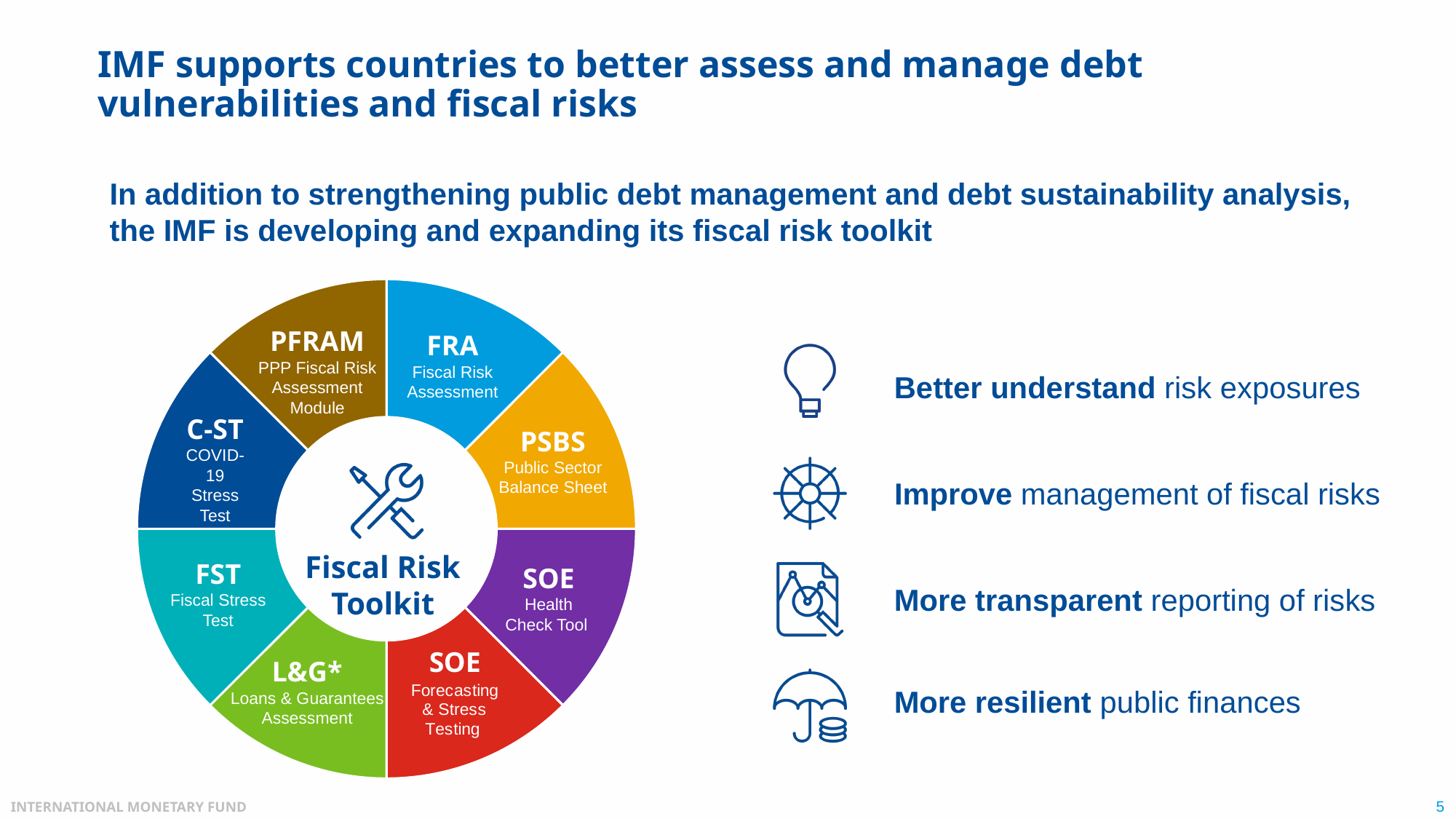
What does the FST segment of the ring diagram stand for? Fiscal Stress Test What does the C-ST segment of the ring diagram stand for? COVID-19 Stress Test How many segments does the Fiscal Risk Toolkit ring diagram have? 8 What does the L&G* segment of the ring diagram stand for? Loans & Guarantees Assessment How many segments in the ring diagram are labelled SOE? 2 What does the PFRAM segment of the ring diagram stand for? PPP Fiscal Risk Assessment Module What text appears in the centre of the ring diagram? Fiscal Risk Toolkit Which segment of the ring diagram is labelled 'Public Sector Balance Sheet'? PSBS